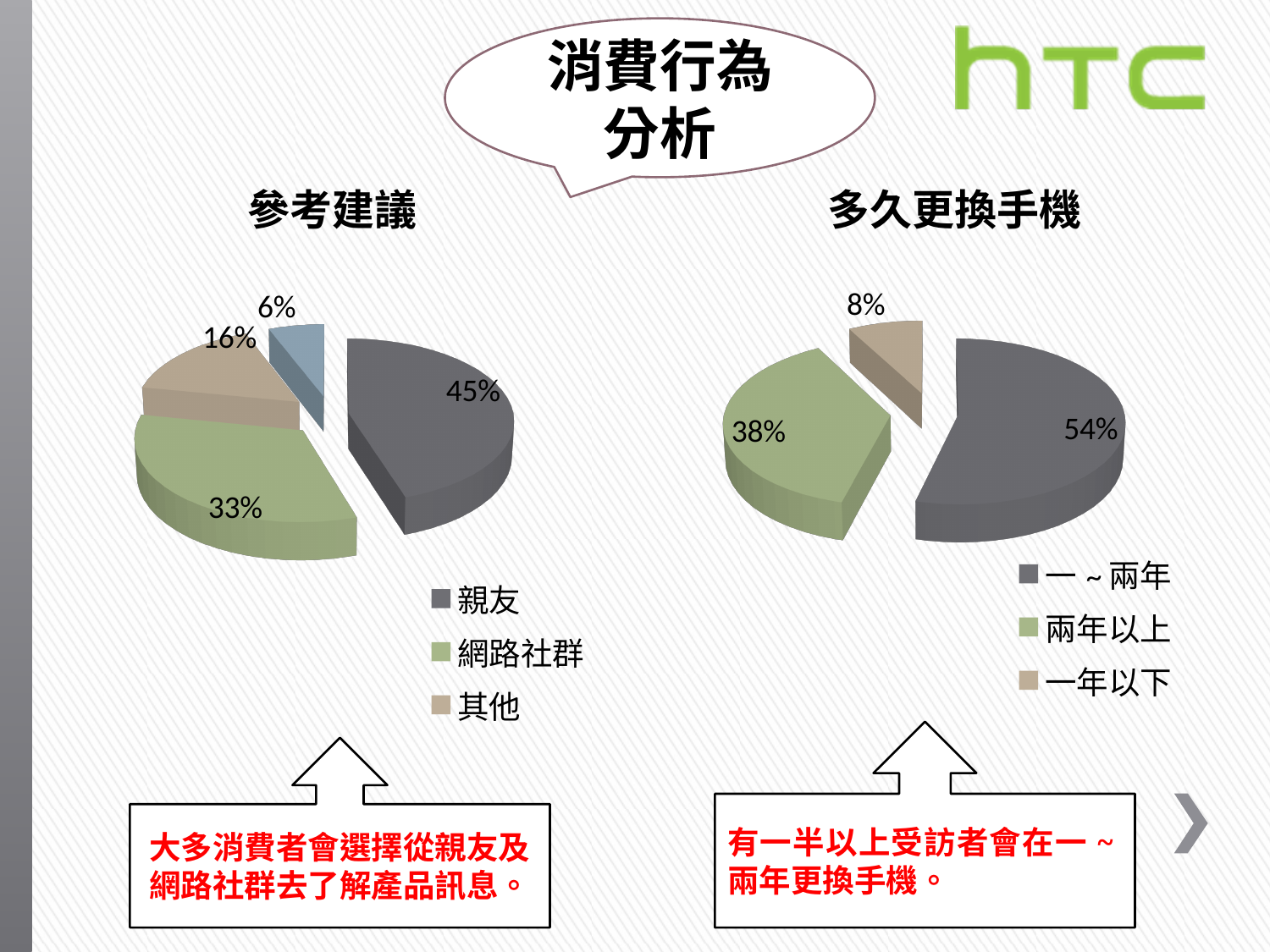
In the 參考建議 chart, how many slices does the pie have? 4 In the 參考建議 chart, what percentage is shown for 網路社群? 33% What kind of chart is the 多久更換手機 chart? Pie chart In the 參考建議 chart, what percentage is shown for 其他? 16% In the 參考建議 chart, what percentage is shown for 親友? 45% In the 多久更換手機 chart, what is the difference between the 一 ~ 兩年 and 兩年以上 slices? 16% In the 參考建議 chart, how many entries does the legend list? 3 In the 多久更換手機 chart, what percentage is shown for 兩年以上? 38% In the 多久更換手機 chart, what percentage is shown for 一 ~ 兩年? 54% In the 多久更換手機 chart, which is larger, 兩年以上 or 一年以下? 兩年以上 In the 參考建議 chart, which category has the largest slice? 親友 In the 多久更換手機 chart, which category has the smallest slice? 一年以下